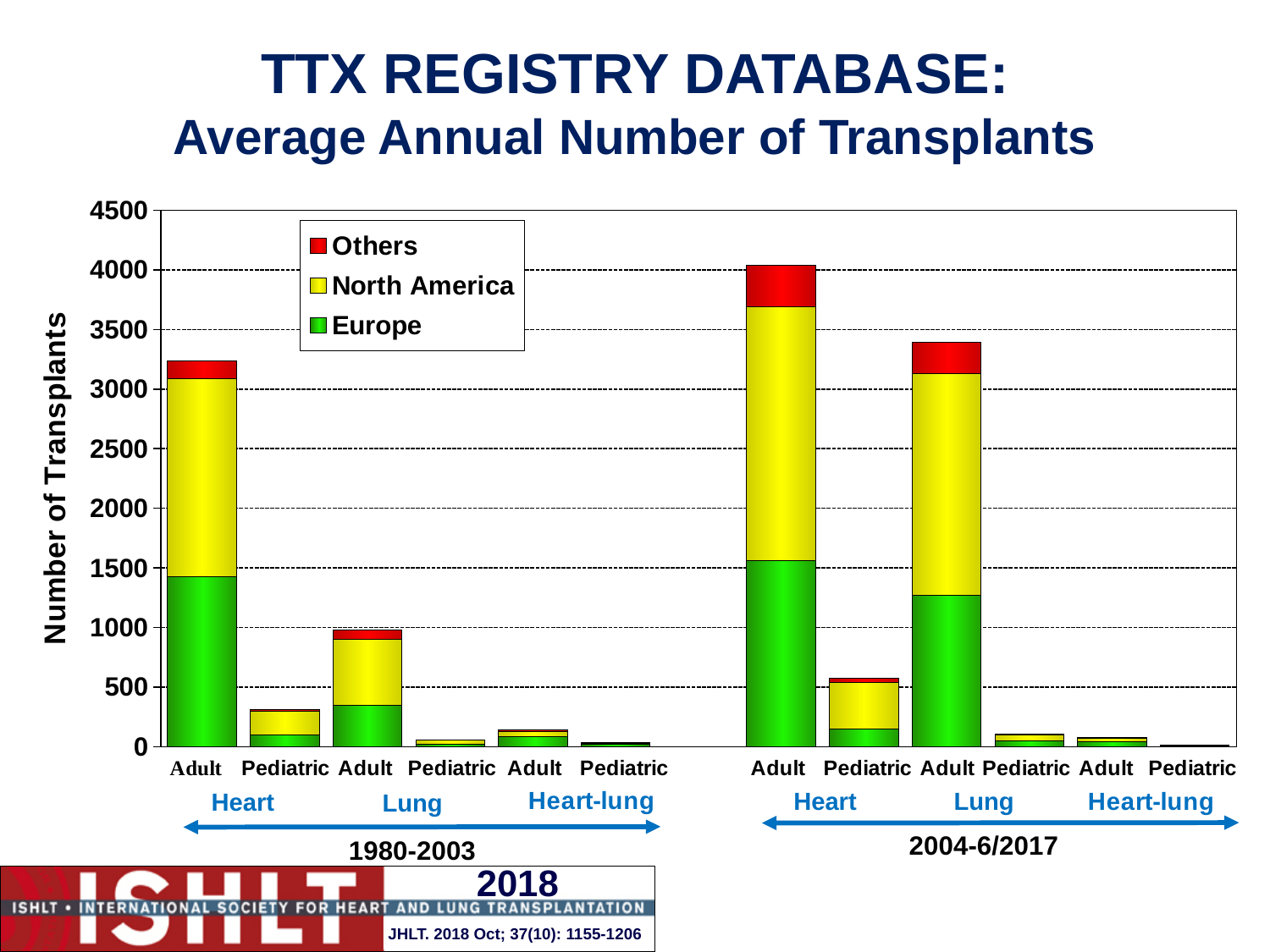
How many bars are plotted in the chart? 12 Is the total for Adult Lung in 2004-6/2017 greater or less than 3500? less Which series are listed in the legend? Others, North America, Europe Which is larger: the total for Adult Heart in 1980-2003 or Adult Heart in 2004-6/2017? Adult Heart in 2004-6/2017 Which colour represents Europe in the chart? Green Which bar is the shortest in the chart? Pediatric Heart-lung, 2004-6/2017 How many series does the legend list? 3 What kind of chart is shown on the slide? Stacked bar chart Is the total for Adult Heart in 1980-2003 greater or less than 3000? greater Which bar is the tallest in the chart? Adult Heart, 2004-6/2017 Is the total for Pediatric Heart in 2004-6/2017 greater or less than 500? greater